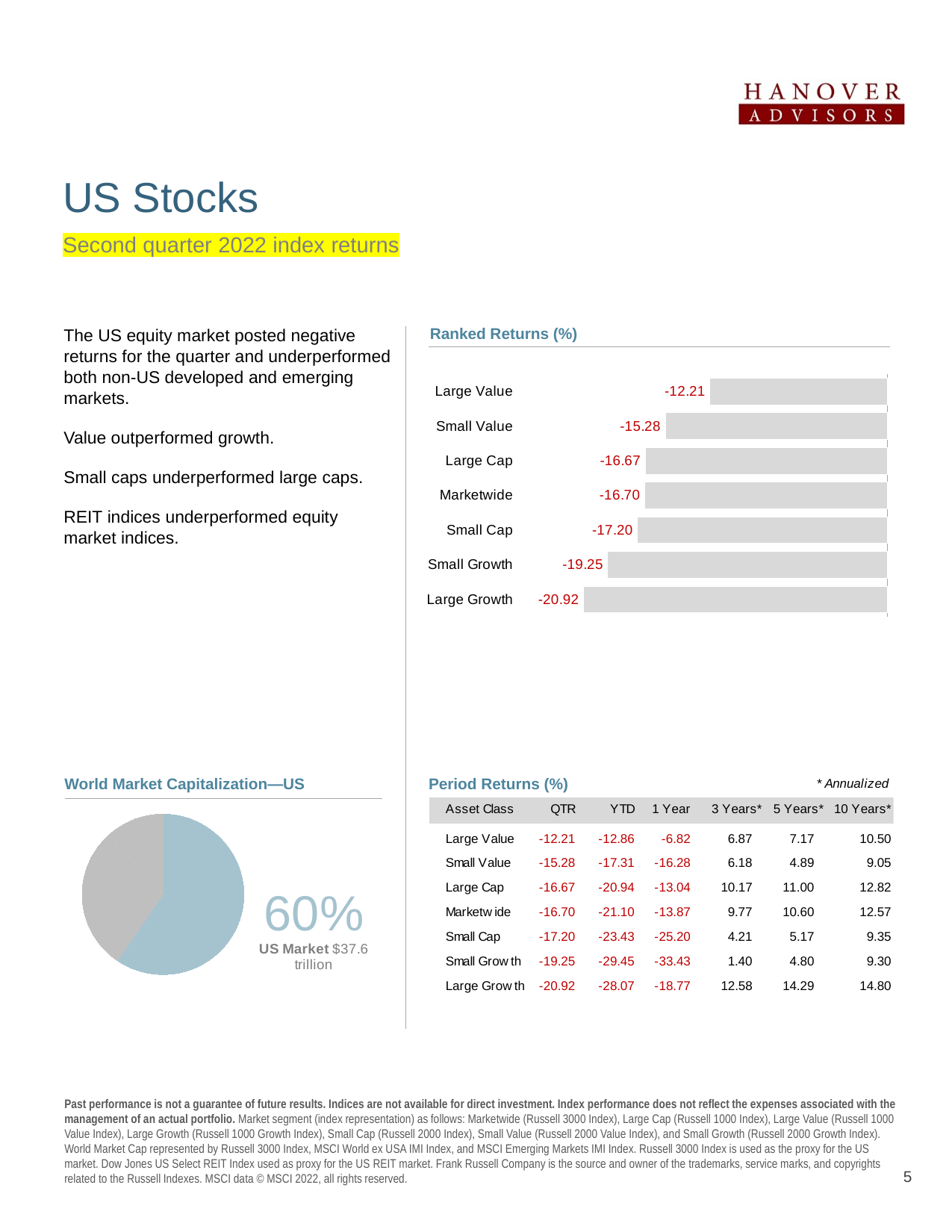
In the Ranked Returns (%) chart, which category has the highest value? Large Value In the Ranked Returns (%) chart, which category has the lowest value? Large Growth In the Ranked Returns (%) chart, what is the value for Large Value? -12.21 How many categories are shown in the Ranked Returns (%) chart? 7 What kind of chart is the Ranked Returns (%) chart? Bar chart What kind of chart is the World Market Capitalization—US chart? Pie chart In the World Market Capitalization—US chart, what share of the pie does the US Market represent? 60% In the Ranked Returns (%) chart, what is the difference between the values for Large Value and Large Growth? 8.71 In the Ranked Returns (%) chart, what is the value for Small Growth? -19.25 In the Ranked Returns (%) chart, what is the value for Marketwide? -16.70 In the World Market Capitalization—US chart, what is the US Market capitalization shown? $37.6 trillion In the Ranked Returns (%) chart, which is larger, the value for Small Value or the value for Small Cap? Small Value